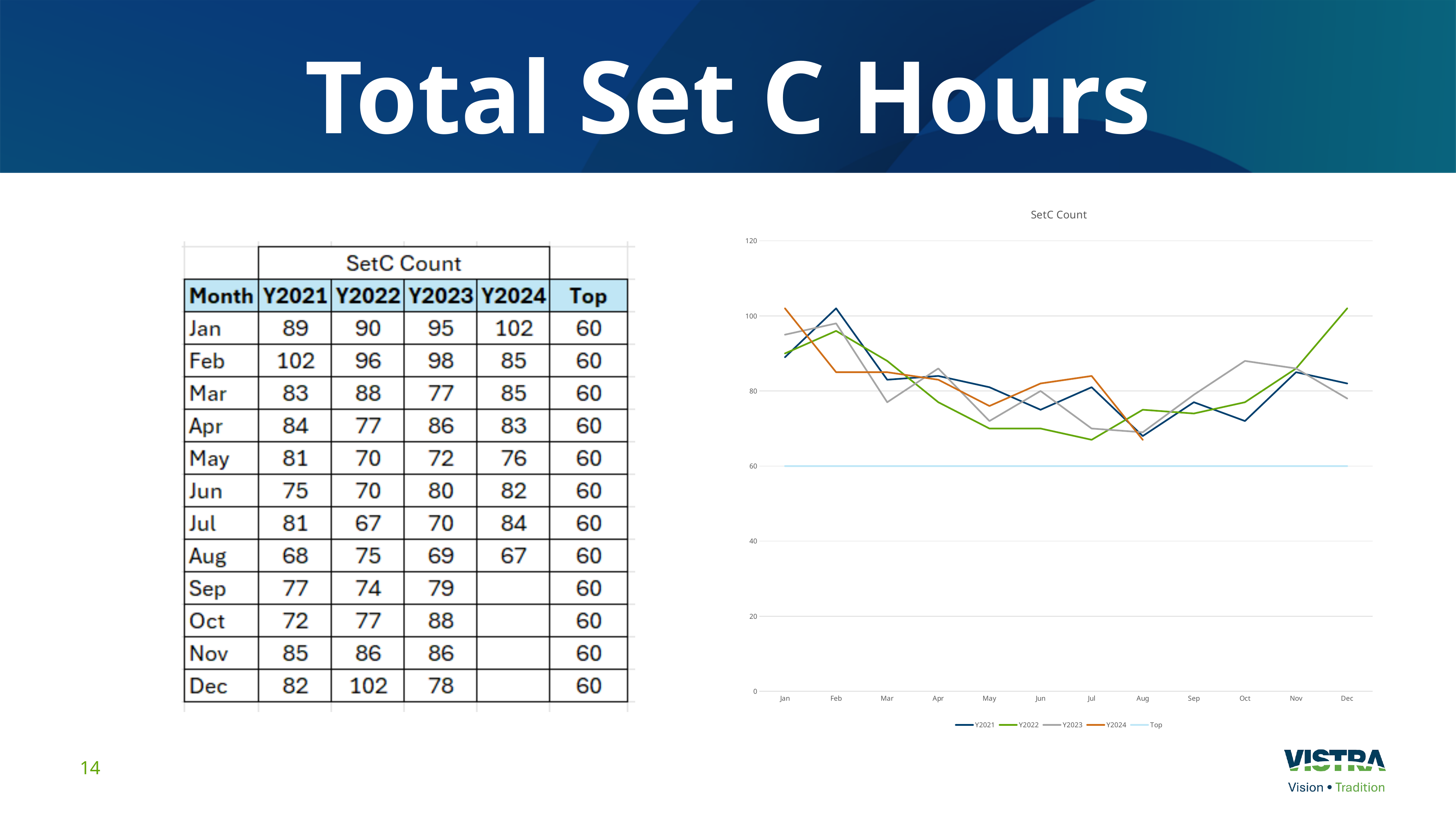
Is the Y2022 value for Dec greater or less than 100? greater In which month does the Y2022 series reach its highest value? Dec Does the Y2022 series rise or fall from Aug to Dec? rise How many series does the legend of the SetC Count chart list? 5 What is the title of the chart on the right of the slide? SetC Count What value does the Top line sit at throughout the year? 60 Which series has the larger value in Oct, Y2021 or Y2023? Y2023 In which month does the Y2022 series reach its lowest value? Jul What kind of chart is shown on the slide? line chart How many months are plotted along the x axis of the SetC Count chart? 12 What is the difference between the Y2021 values for Feb and Aug? 34 What is the Y2024 value for Jan? 102